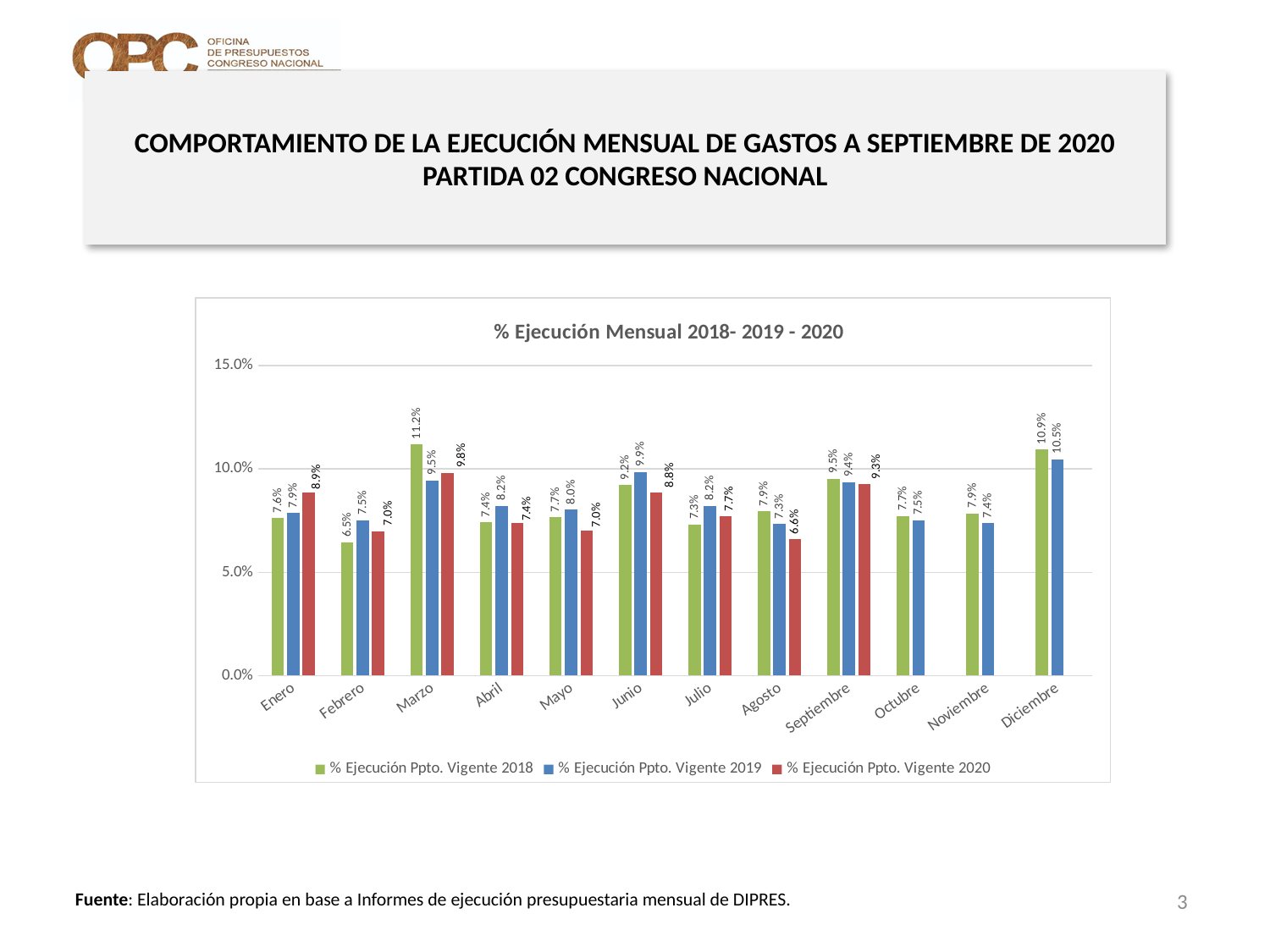
Which is larger in Enero: the 2018 value or the 2020 value? 2020 value (8.9%) What is the value for % Ejecución Ppto. Vigente 2019 in Junio? 9.9% Which month has the lowest value for % Ejecución Ppto. Vigente 2020? Agosto Which month has the highest value for % Ejecución Ppto. Vigente 2018? Marzo How many series does the legend list? 3 Which colour represents % Ejecución Ppto. Vigente 2019? Blue What is the difference between the 2018 and 2019 values in Marzo? 1.7% What kind of chart is shown on the slide? Bar chart What is the value for % Ejecución Ppto. Vigente 2020 in Marzo? 9.8% What is the title of the chart? % Ejecución Mensual 2018- 2019 - 2020 How many months are shown on the x axis? 12 What is the value for % Ejecución Ppto. Vigente 2018 in Diciembre? 10.9%